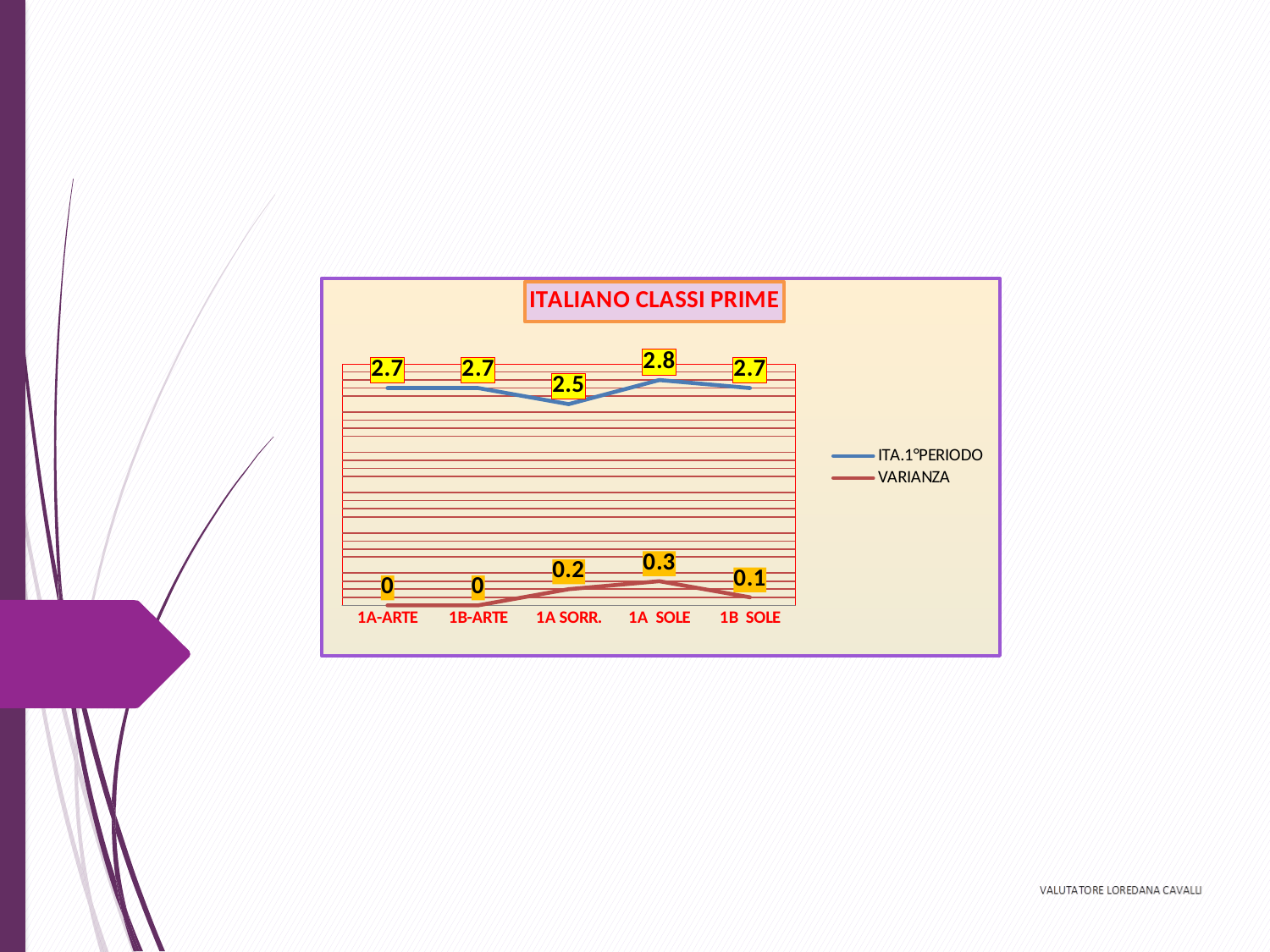
How many categories are shown on the x axis? 5 What is the title of the chart? ITALIANO CLASSI PRIME What is the VARIANZA value for 1A SOLE? 0.3 Which category has the highest VARIANZA value? 1A SOLE What is the ITA.1°PERIODO value for 1B SOLE? 2.7 What is the VARIANZA value for 1B-ARTE? 0 How many series does the legend list? 2 Which category has the lowest ITA.1°PERIODO value? 1A SORR. Which category has the highest ITA.1°PERIODO value? 1A SOLE Is the VARIANZA value larger for 1A SORR. or for 1B SOLE? 1A SORR. What is the difference between the ITA.1°PERIODO values for 1A SOLE and 1A SORR.? 0.3 What is the ITA.1°PERIODO value for 1A SORR.? 2.5